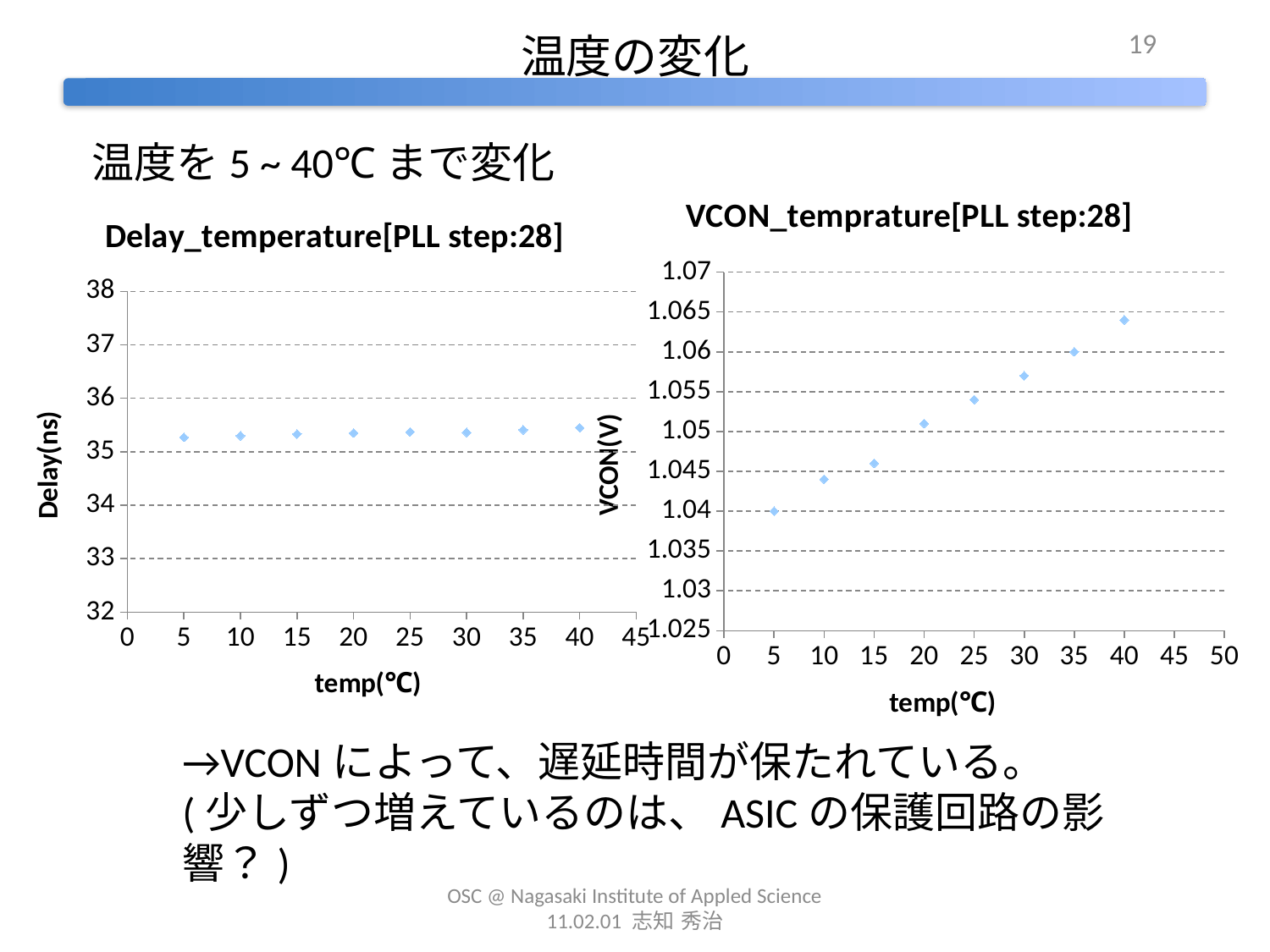
In the Delay_temperature[PLL step:28] chart, is the delay at 20°C greater or less than 36? less What is the y-axis label of the Delay_temperature[PLL step:28] chart? Delay(ns) In the VCON_temprature[PLL step:28] chart, at which temperature is VCON highest? 40 In the VCON_temprature[PLL step:28] chart, at which temperature is VCON lowest? 5 How many data points are plotted in the VCON_temprature[PLL step:28] chart? 8 How many data points are plotted in the Delay_temperature[PLL step:28] chart? 8 In the VCON_temprature[PLL step:28] chart, what is the VCON value at 35°C? 1.06 In the VCON_temprature[PLL step:28] chart, do the VCON values rise or fall as temperature increases? rise What kind of chart is the Delay_temperature[PLL step:28] chart? scatter chart In the VCON_temprature[PLL step:28] chart, which has the larger VCON value, 10°C or 30°C? 30°C In the VCON_temprature[PLL step:28] chart, is the VCON value at 25°C greater or less than 1.05? greater In the VCON_temprature[PLL step:28] chart, what is the VCON value at 5°C? 1.04